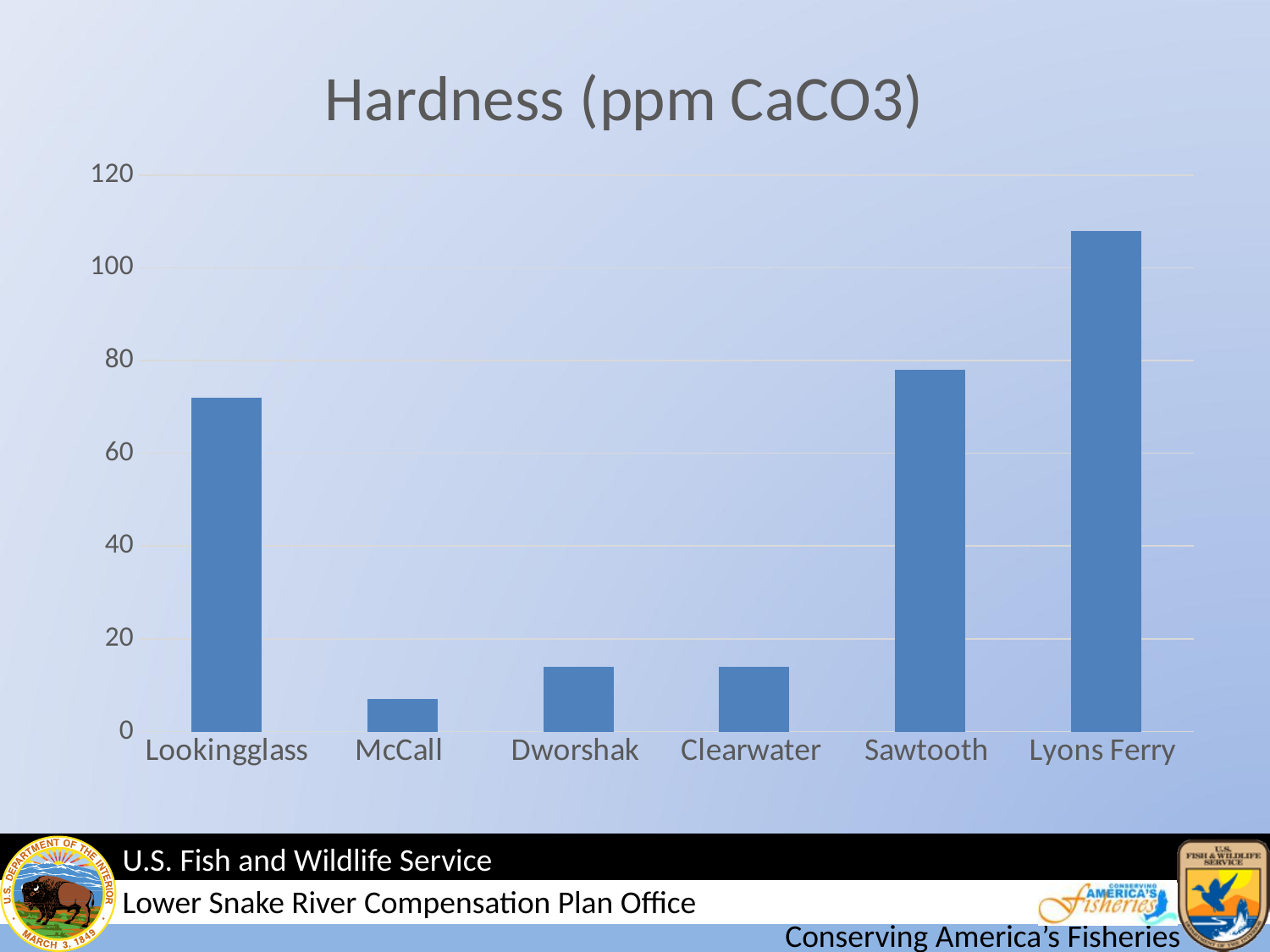
Is the value for Sawtooth greater or less than 60? greater Is the value for Lyons Ferry greater or less than 100? greater How many hatcheries (categories) are shown on the x axis? 6 Which hatchery has the lowest hardness value? McCall Is the value for Lookingglass greater or less than 80? less What is the title of the chart? Hardness (ppm CaCO3) What kind of chart is shown on the slide? bar chart Which hatchery has the highest hardness value? Lyons Ferry Which has a larger hardness value, Lookingglass or Clearwater? Lookingglass Which has a larger hardness value, Lyons Ferry or Sawtooth? Lyons Ferry